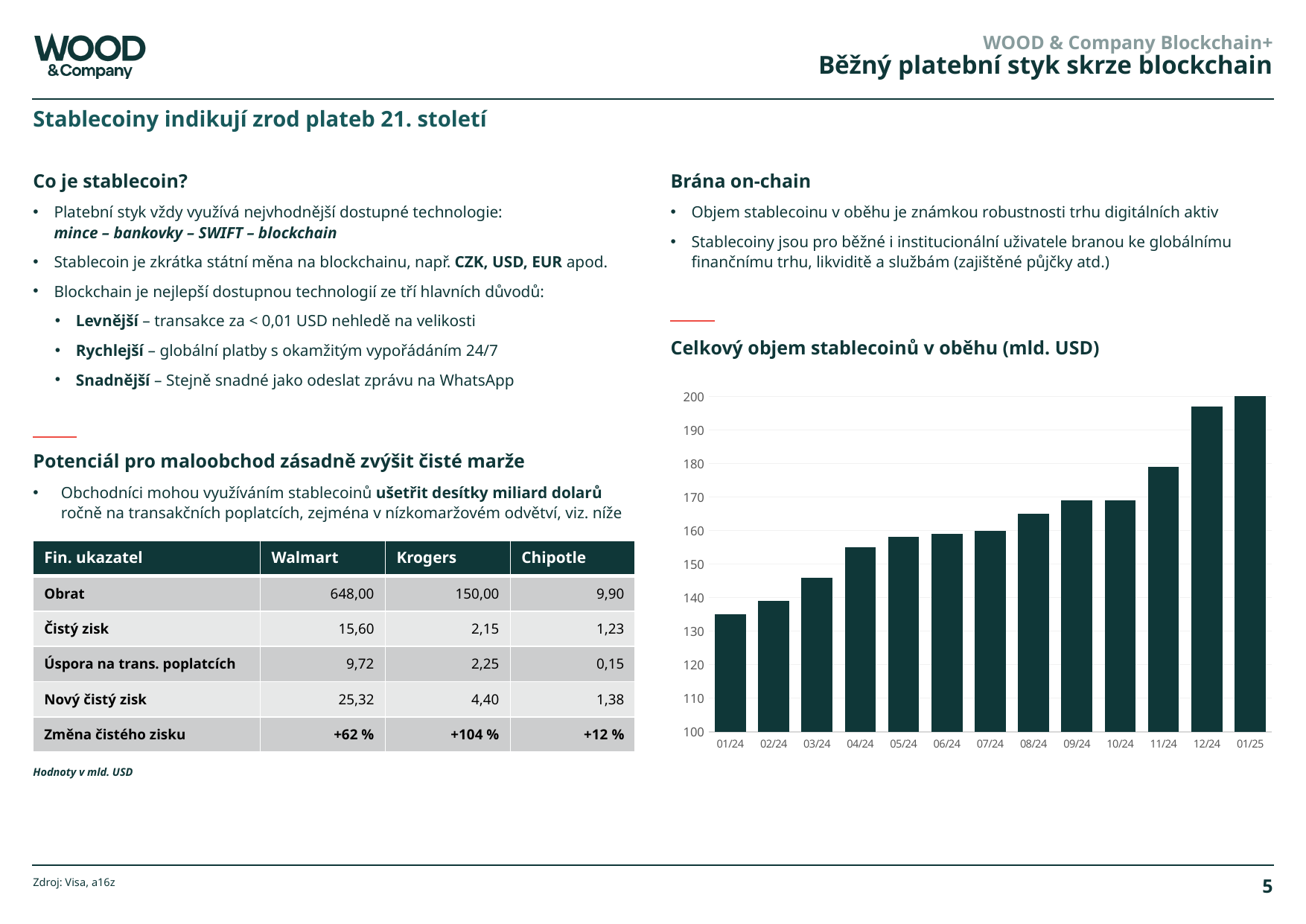
In the chart "Celkový objem stablecoinů v oběhu (mld. USD)", is the value for 11/24 greater or less than 170? greater In the chart "Celkový objem stablecoinů v oběhu (mld. USD)", which is larger, the value for 08/24 or the value for 11/24? 11/24 In the chart "Celkový objem stablecoinů v oběhu (mld. USD)", which month has the highest value? 01/25 In the chart "Celkový objem stablecoinů v oběhu (mld. USD)", is the value for 04/24 greater or less than 150? greater What is the title of the chart on the right side of the slide? Celkový objem stablecoinů v oběhu (mld. USD) What kind of chart is shown under the title "Celkový objem stablecoinů v oběhu (mld. USD)"? bar chart In the chart "Celkový objem stablecoinů v oběhu (mld. USD)", is the value for 01/24 greater or less than 140? less How many bars (months) are plotted in the chart "Celkový objem stablecoinů v oběhu (mld. USD)"? 13 In the chart "Celkový objem stablecoinů v oběhu (mld. USD)", which month has the lowest value? 01/24 In the chart "Celkový objem stablecoinů v oběhu (mld. USD)", do the values generally rise or fall from 01/24 to 01/25? rise